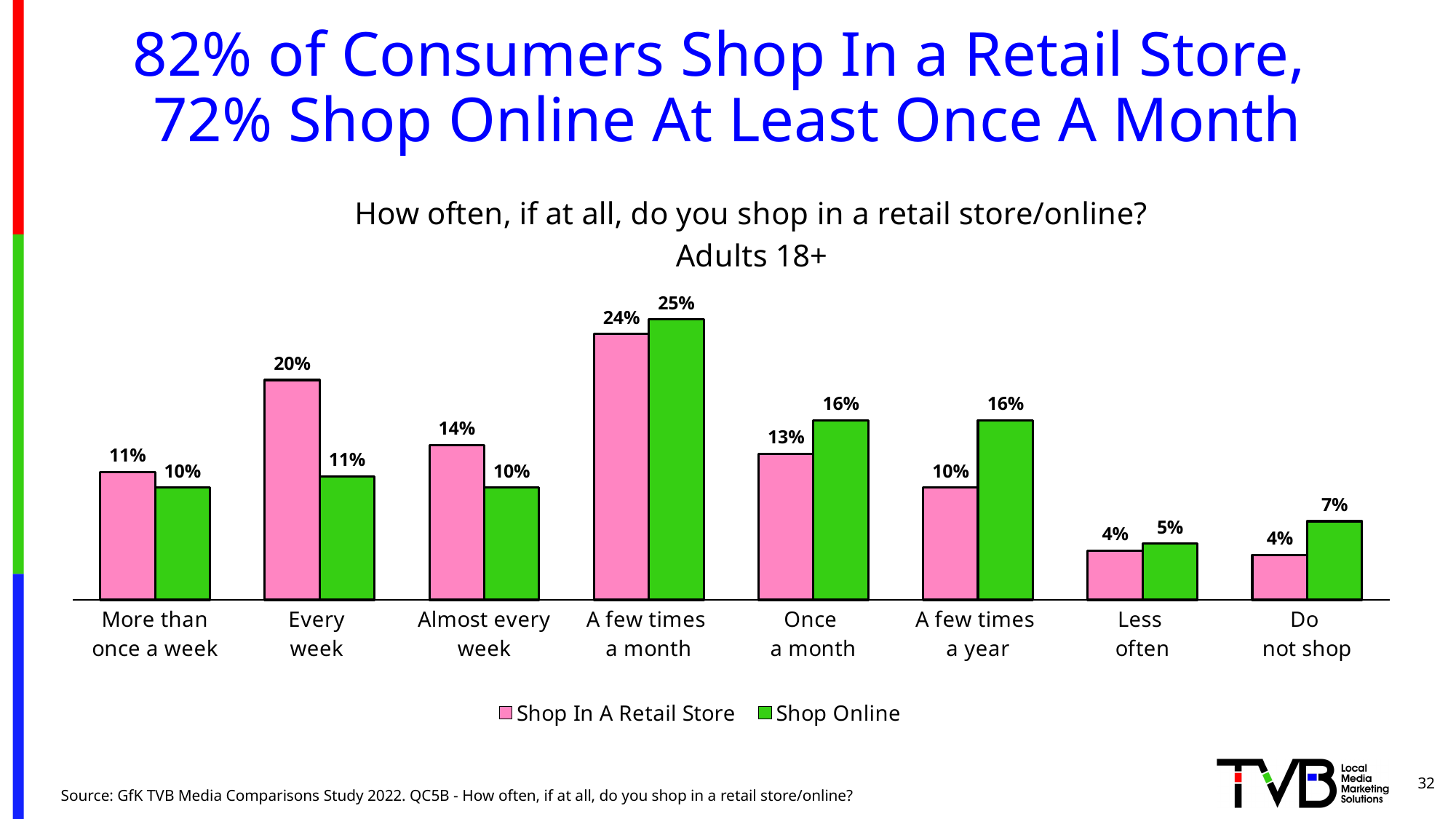
Which category has the lowest value for Shop Online? Less often Which colour represents the Shop Online series? Green What kind of chart is shown on the slide? Bar chart What percentage of adults shop online a few times a month? 25% How many frequency categories are shown on the x axis? 8 How many series does the legend list? 2 What is the Shop Online value for the 'Do not shop' category? 7% Which category has the highest value for Shop In A Retail Store? A few times a month What is the difference between the Shop Online values for 'Once a month' and 'Do not shop'? 9% What percentage of adults shop in a retail store every week? 20% What is the difference between the Shop In A Retail Store and Shop Online values for 'Every week'? 9% For 'A few times a year', which is larger: Shop In A Retail Store or Shop Online? Shop Online